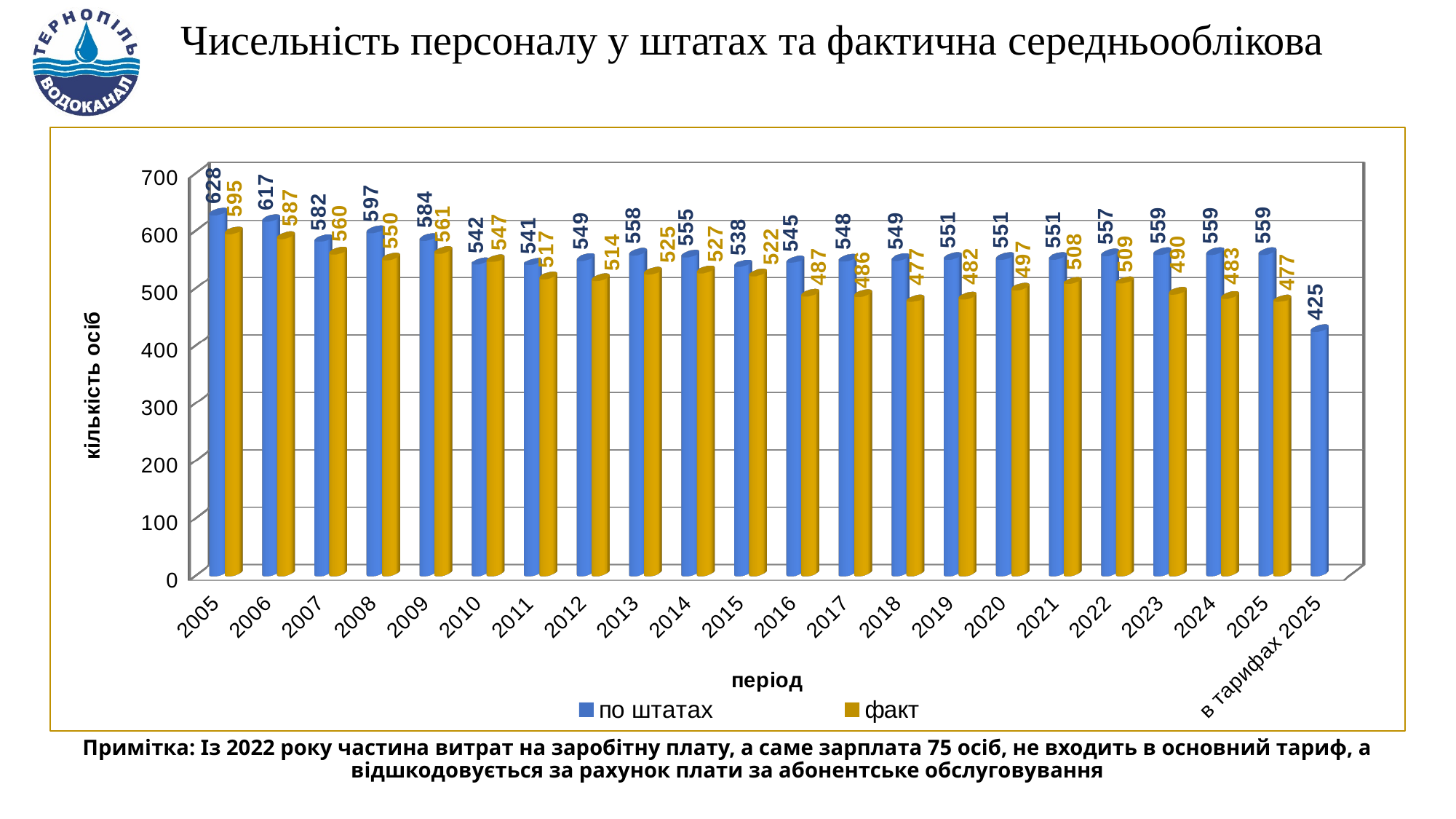
In 2010, which is larger: 'по штатах' or 'факт'? факт What is the value of 'по штатах' for 2005? 628 What is the value of 'факт' for 2016? 487 What is the difference between 'по штатах' and 'факт' in 2005? 33 How many periods are shown on the x axis? 22 Which period has the highest 'по штатах' value? 2005 Which period has the highest 'факт' value? 2005 What is the value of 'по штатах' for 'в тарифах 2025'? 425 What type of chart is shown on the slide? bar chart What is the label of the y axis? кількість осіб Which period has the lowest 'по штатах' value? в тарифах 2025 How many series does the legend list? 2